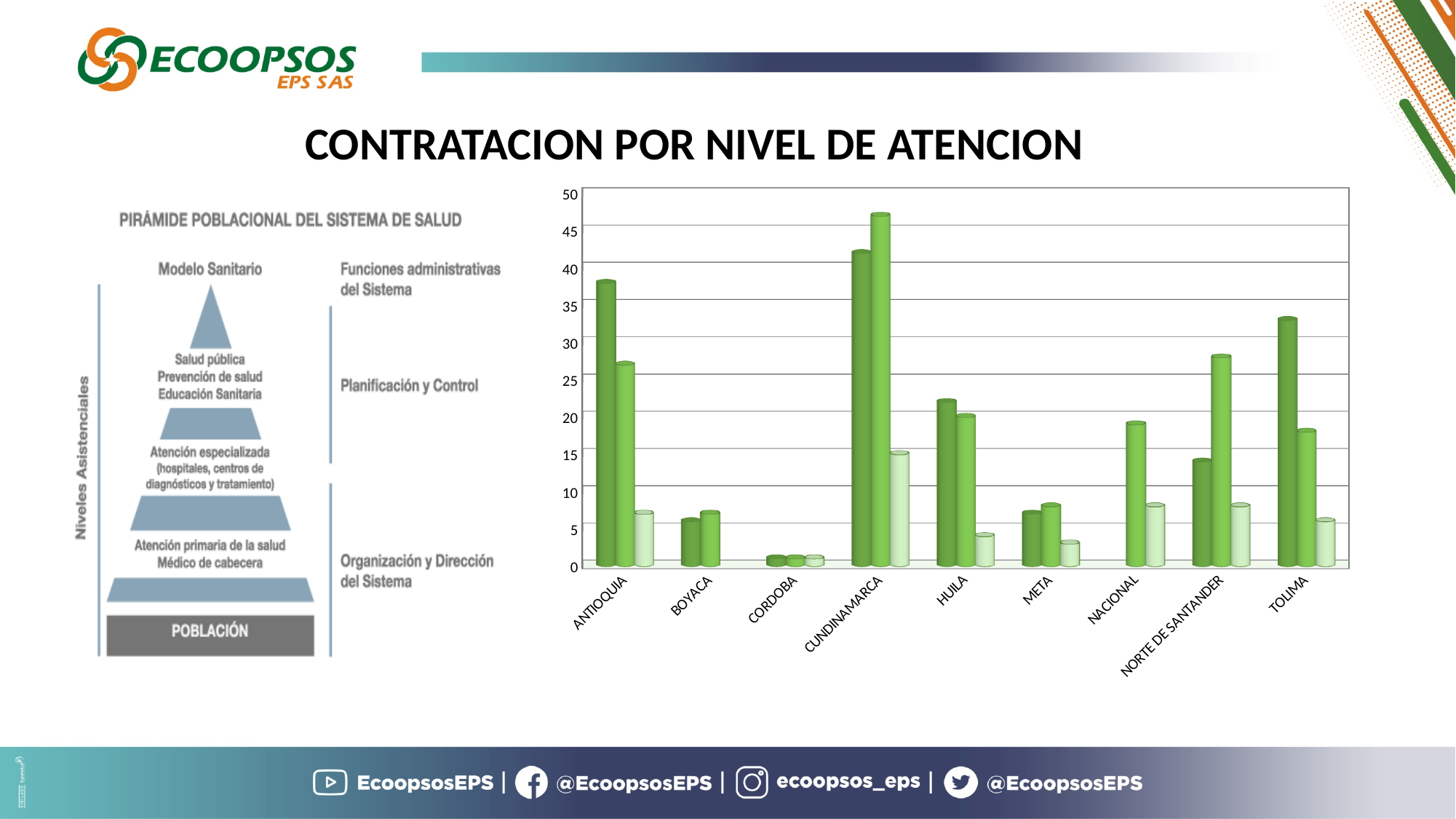
Are the bars for CORDOBA greater or less than 5? less Is the value of the first (darkest green) bar for ANTIOQUIA greater or less than 35? greater How many categories are shown on the x axis of the chart? 9 Which category has the tallest bar in the chart? CUNDINAMARCA What is the title of the slide containing the chart? CONTRATACION POR NIVEL DE ATENCION Which is larger: the first (darkest green) bar for ANTIOQUIA or the first (darkest green) bar for TOLIMA? ANTIOQUIA What kind of chart is shown on the slide? bar chart Is the value of the second (medium green) bar for CUNDINAMARCA greater or less than 45? greater How many bars are plotted for each category in the chart? 3 (BOYACA and NACIONAL show only 2) Which category has the lowest bars overall in the chart? CORDOBA